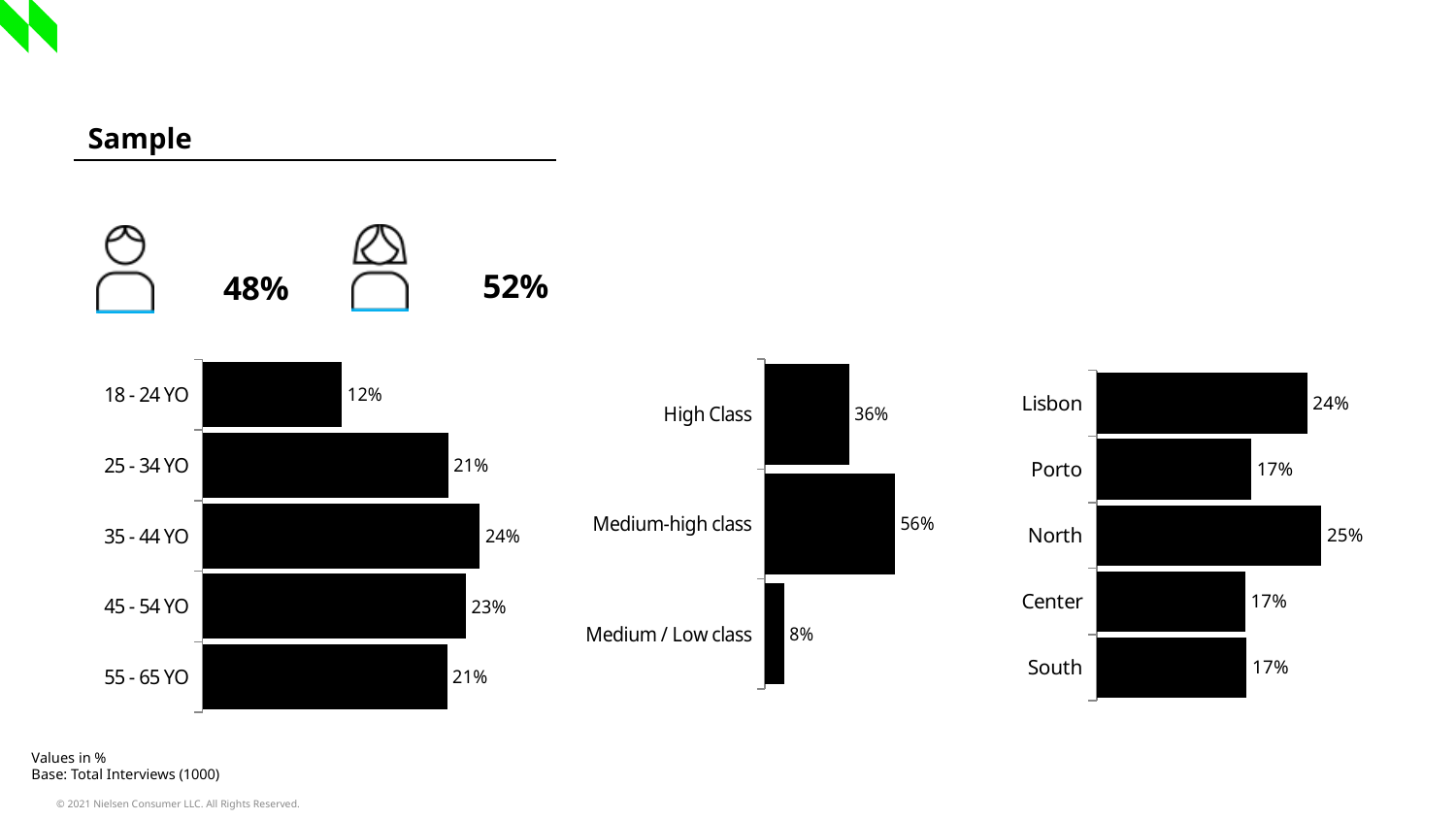
In the social class chart in the middle, which category has the highest value? Medium-high class What kind of chart is the social class chart in the middle? Bar chart In the age group chart on the left, what is the difference between the values for 35 - 44 YO and 18 - 24 YO? 12% In the region chart on the right, what is the value for North? 25% In the region chart on the right, which region has the highest value? North In the age group chart on the left, what is the value for 35 - 44 YO? 24% In the age group chart on the left, which age group has the lowest value? 18 - 24 YO In the social class chart in the middle, what is the value for Medium-high class? 56% In the region chart on the right, how many regions are shown? 5 In the region chart on the right, which is larger, the value for Lisbon or the value for Porto? Lisbon In the age group chart on the left, how many age groups are shown? 5 In the social class chart in the middle, what is the difference between High Class and Medium / Low class? 28%